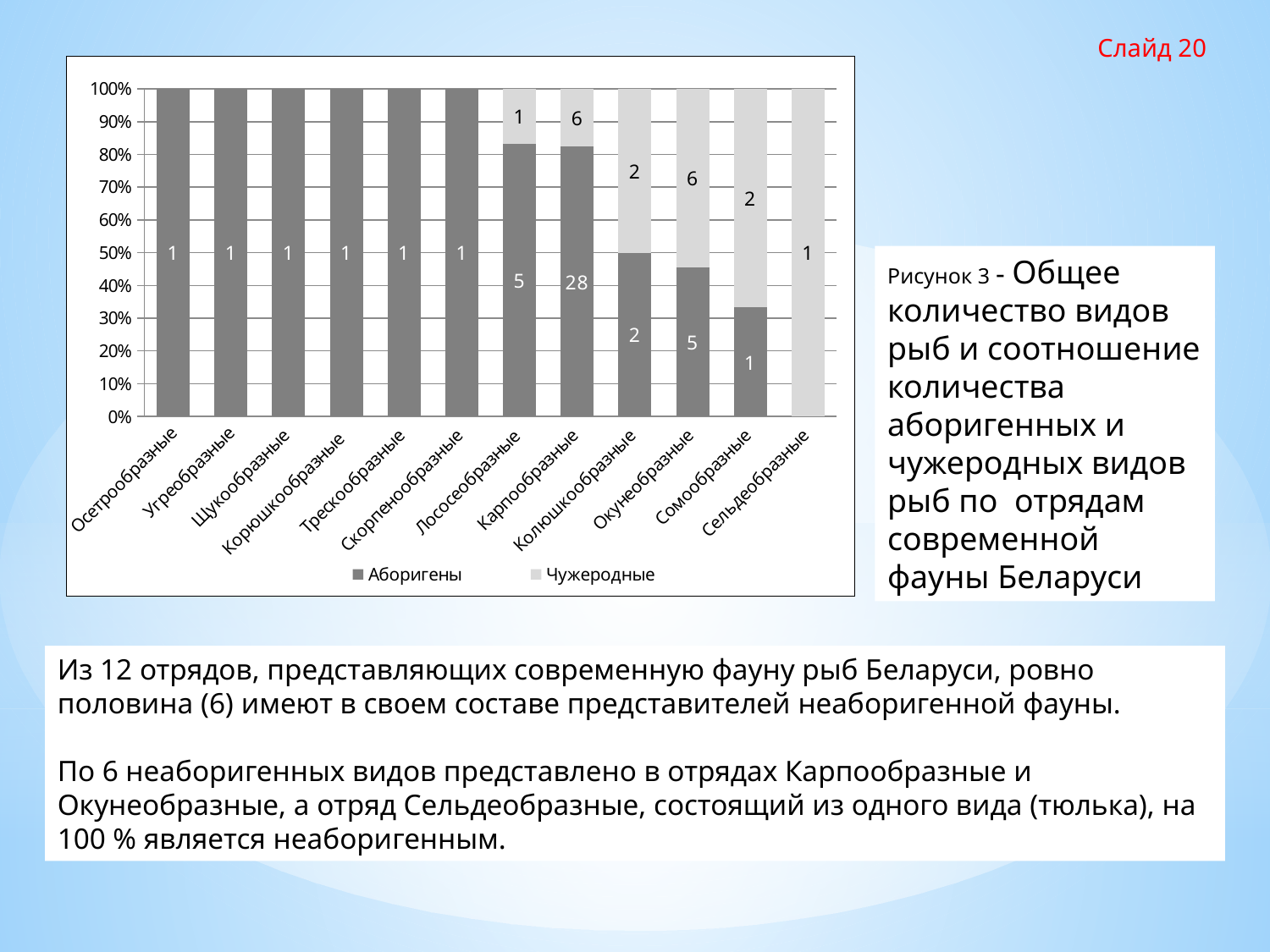
How many alien (Чужеродные) species are shown for Окунеобразные? 6 How many native (Аборигены) species are shown for Карпообразные? 28 What is the total number of species (native plus alien) in the Окунеобразные bar? 11 How many series does the legend list? 2 How many orders (categories) are shown on the x axis? 12 What kind of chart is shown on the slide? Stacked bar chart What is the difference between the number of native and alien species for Карпообразные? 22 Which order has the highest number of native (Аборигены) species? Карпообразные Which has more alien (Чужеродные) species, Сомообразные or Окунеобразные? Окунеобразные How many native (Аборигены) species are shown for Лососеобразные? 5 What is the total number of species (native plus alien) in the Карпообразные bar? 34 Is the native (Аборигены) share for Сомообразные greater or less than 40%? less